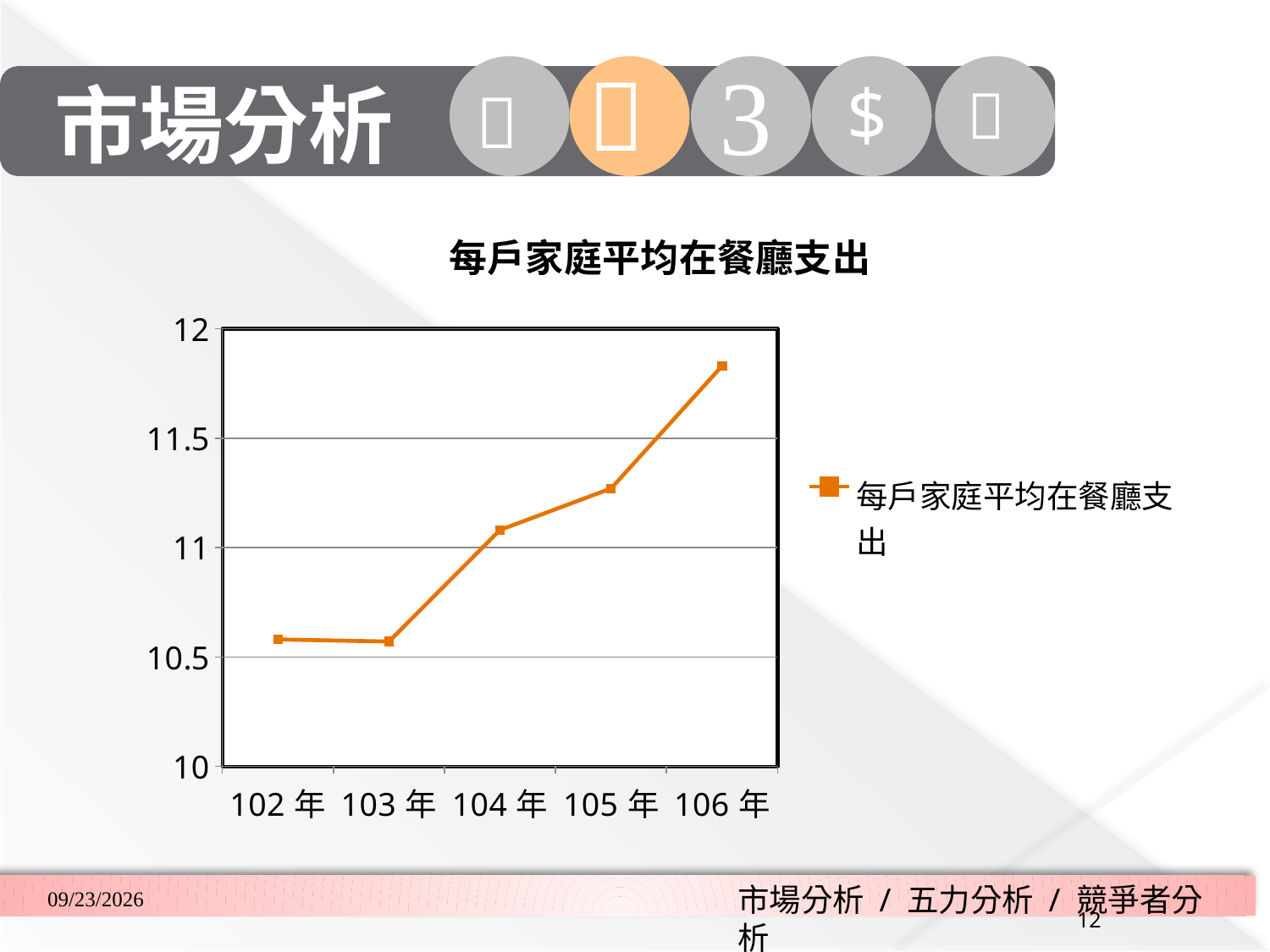
Is the value for 106 年 greater or less than 11.5? greater Which is larger, the value for 104 年 or the value for 105 年? 105 年 How many data points are plotted on the line? 5 What is the first year shown on the x axis? 102 年 Is the value for 105 年 greater or less than 11.5? less What kind of chart is shown on the slide? line chart Is the value for 102 年 greater or less than 11? less How many series does the legend list? 1 Which year has the highest value? 106 年 Do the values generally rise or fall from 102 年 to 106 年? rise What is the title of the chart? 每戶家庭平均在餐廳支出